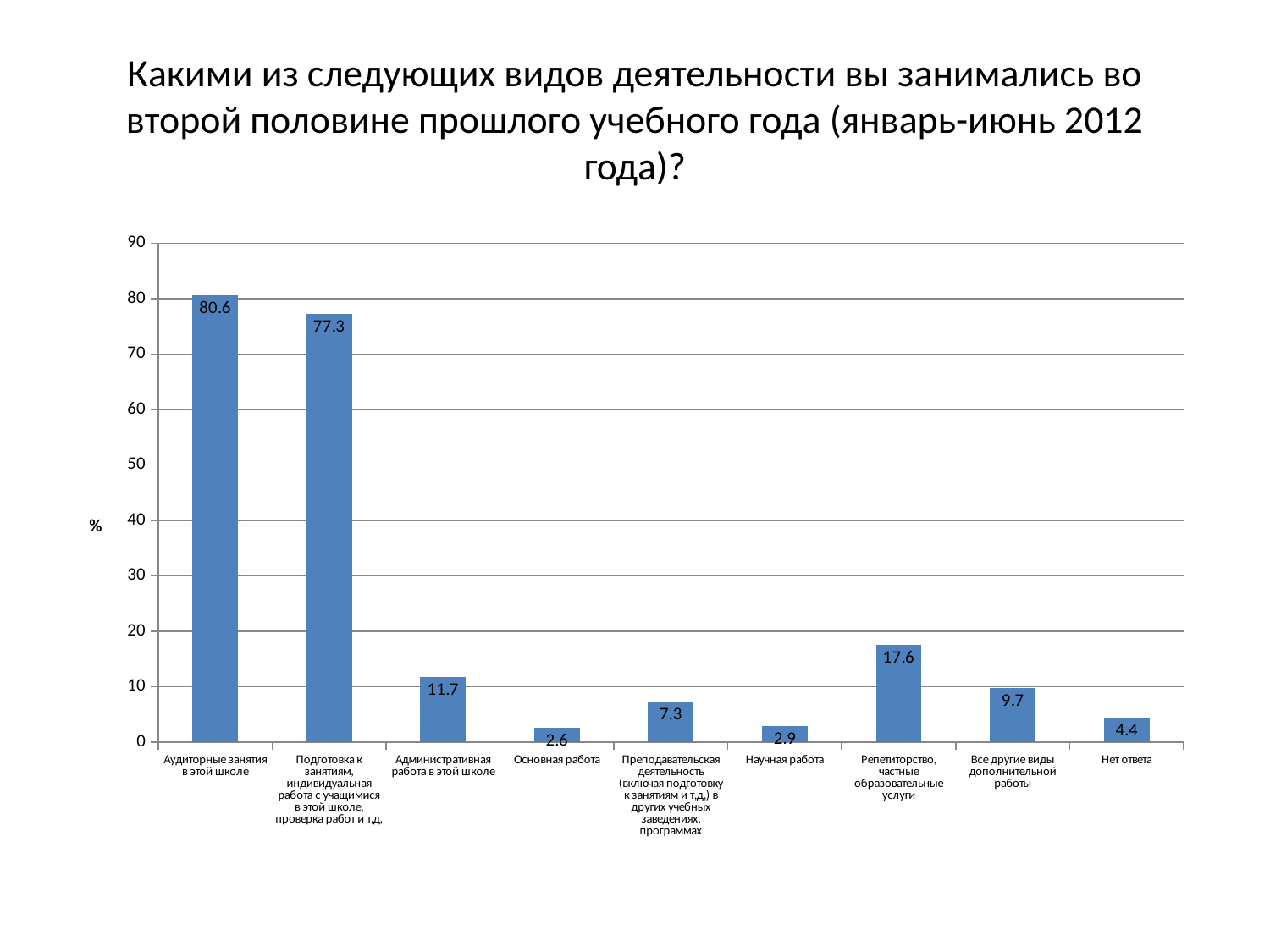
What is the value for «Репетиторство, частные образовательные услуги»? 17.6 What is the value for «Аудиторные занятия в этой школе»? 80.6 How many categories are shown on the x axis? 9 Which is larger: the value for «Административная работа в этой школе» or the value for «Все другие виды дополнительной работы»? Административная работа в этой школе What is the label of the vertical axis? % What is the difference between the values for «Аудиторные занятия в этой школе» and «Подготовка к занятиям, индивидуальная работа с учащимися в этой школе, проверка работ и т.д.»? 3.3 What is the value for «Нет ответа»? 4.4 Which category has the highest value? Аудиторные занятия в этой школе What kind of chart is shown on the slide? bar chart Which category has the lowest value? Основная работа What is the difference between the values for «Научная работа» and «Основная работа»? 0.3 Is the value for «Репетиторство, частные образовательные услуги» greater or less than 20? less